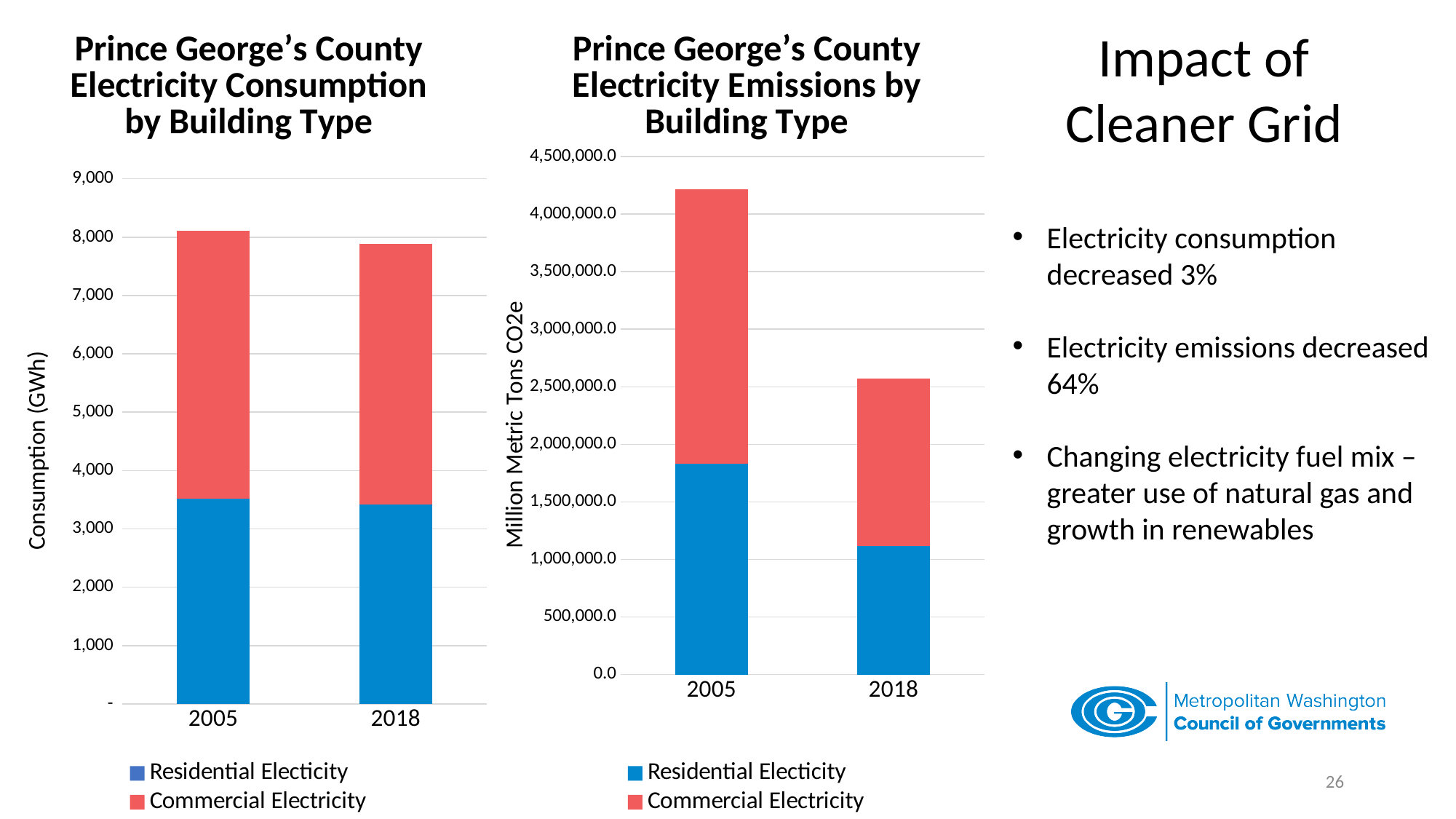
On the Prince George's County Electricity Consumption by Building Type chart, is the total consumption bar for 2018 greater or less than 8,000? less How many series does the legend list on the Prince George's County Electricity Emissions by Building Type chart? 2 What is the y-axis label of the Prince George's County Electricity Emissions by Building Type chart? Million Metric Tons CO2e On the Prince George's County Electricity Consumption by Building Type chart, which colour represents Commercial Electricity? red What kind of chart is the Prince George's County Electricity Consumption by Building Type chart? stacked bar chart On the Prince George's County Electricity Emissions by Building Type chart, do total emissions rise or fall from 2005 to 2018? fall On the Prince George's County Electricity Emissions by Building Type chart, which year has the higher total emissions, 2005 or 2018? 2005 On the Prince George's County Electricity Consumption by Building Type chart, is the Residential Electicity value for 2005 greater or less than 4,000? less On the Prince George's County Electricity Emissions by Building Type chart, is the total emissions bar for 2005 greater or less than 4,000,000.0? greater How many years are shown on the x axis of the Prince George's County Electricity Consumption by Building Type chart? 2